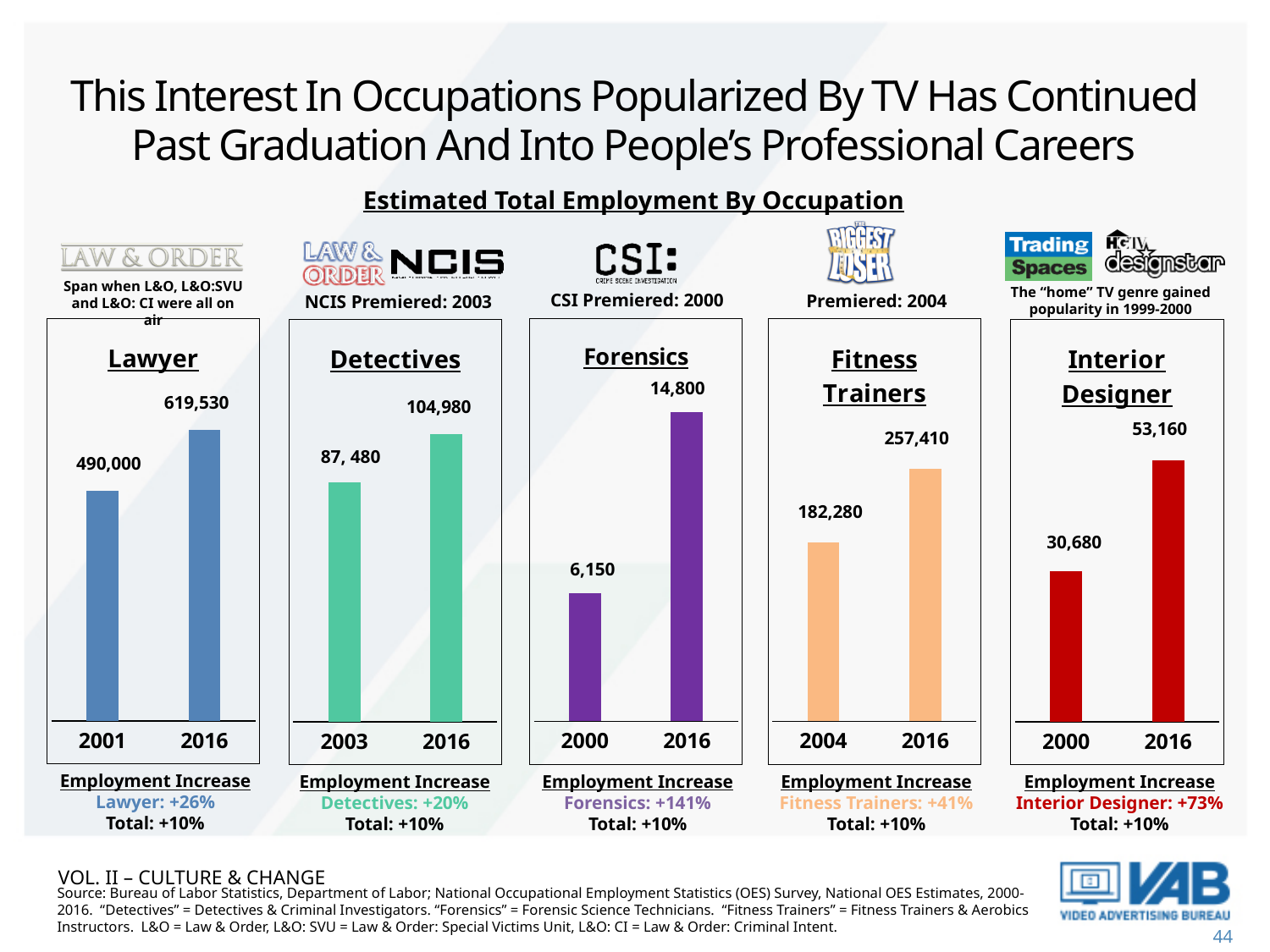
In the Forensics chart, what is the value for 2000? 6,150 What kind of chart is the Forensics chart? bar chart In the Detectives chart, what is the value for 2016? 104,980 In the Lawyer chart, do the values rise or fall from 2001 to 2016? rise In the Interior Designer chart, what is the value for 2016? 53,160 In the Interior Designer chart, what is the difference between the 2016 and 2000 values? 22,480 In the Lawyer chart, what is the value for 2001? 490,000 In the Fitness Trainers chart, what is the value for 2004? 182,280 In the Lawyer chart, what is the value for 2016? 619,530 In the Fitness Trainers chart, which year has the higher value, 2004 or 2016? 2016 In the Forensics chart, what is the difference between the 2016 and 2000 values? 8,650 How many bars are in the Detectives chart? 2